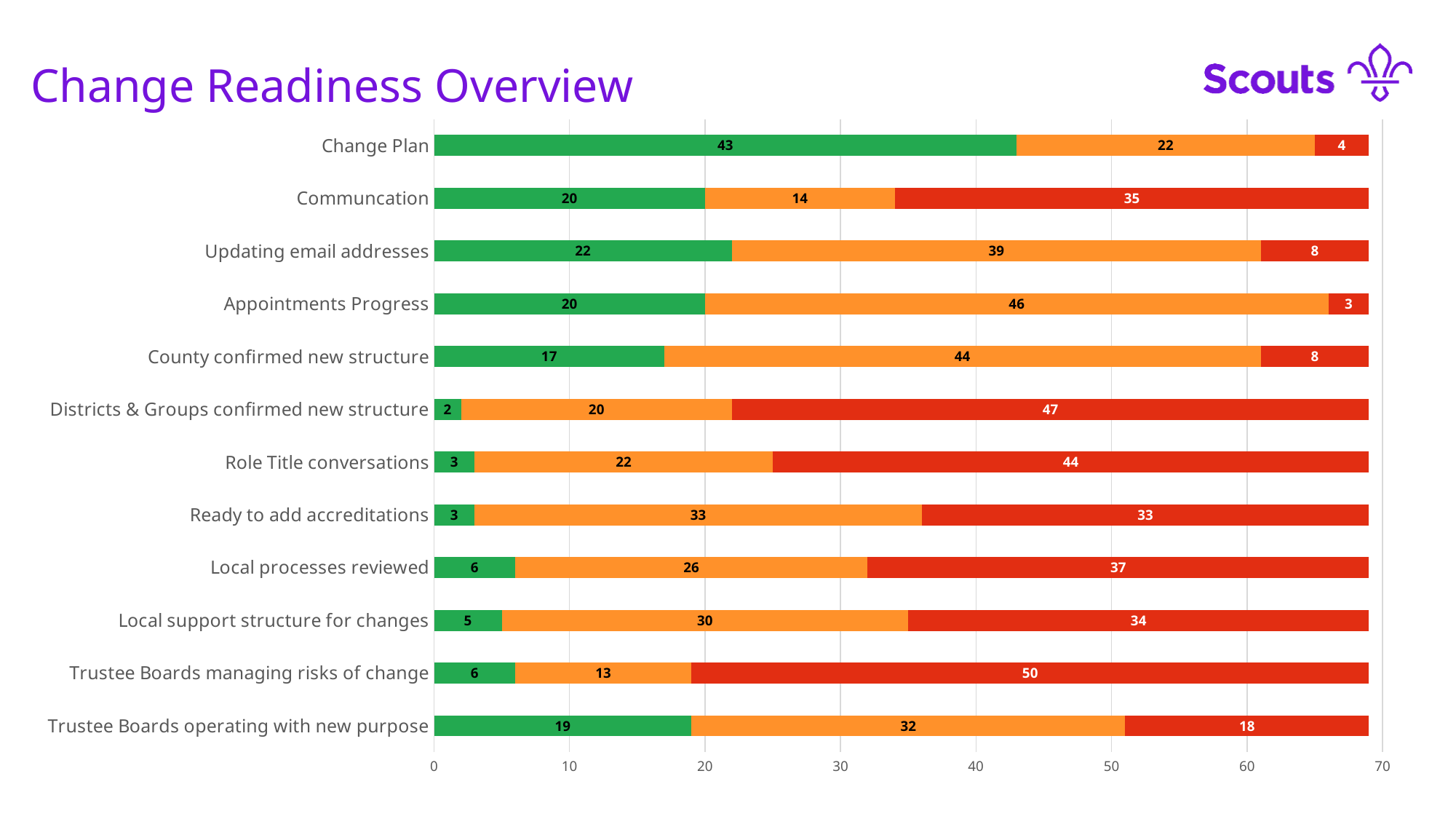
How many categories are plotted on the chart? 12 Is the total bar length for Change Plan greater or less than 60? greater What is the title of the slide? Change Readiness Overview Which is larger: the orange segment for Updating email addresses or the orange segment for County confirmed new structure? County confirmed new structure What is the value of the red segment for Trustee Boards managing risks of change? 50 What is the total of the stacked bar for Communcation? 69 Which category has the smallest green segment? Districts & Groups confirmed new structure What is the value of the green segment for Change Plan? 43 What type of chart is shown on the slide? stacked bar chart Which category has the largest green segment? Change Plan What is the difference between the red segment for Districts & Groups confirmed new structure and the red segment for Role Title conversations? 3 What is the value of the orange segment for Appointments Progress? 46